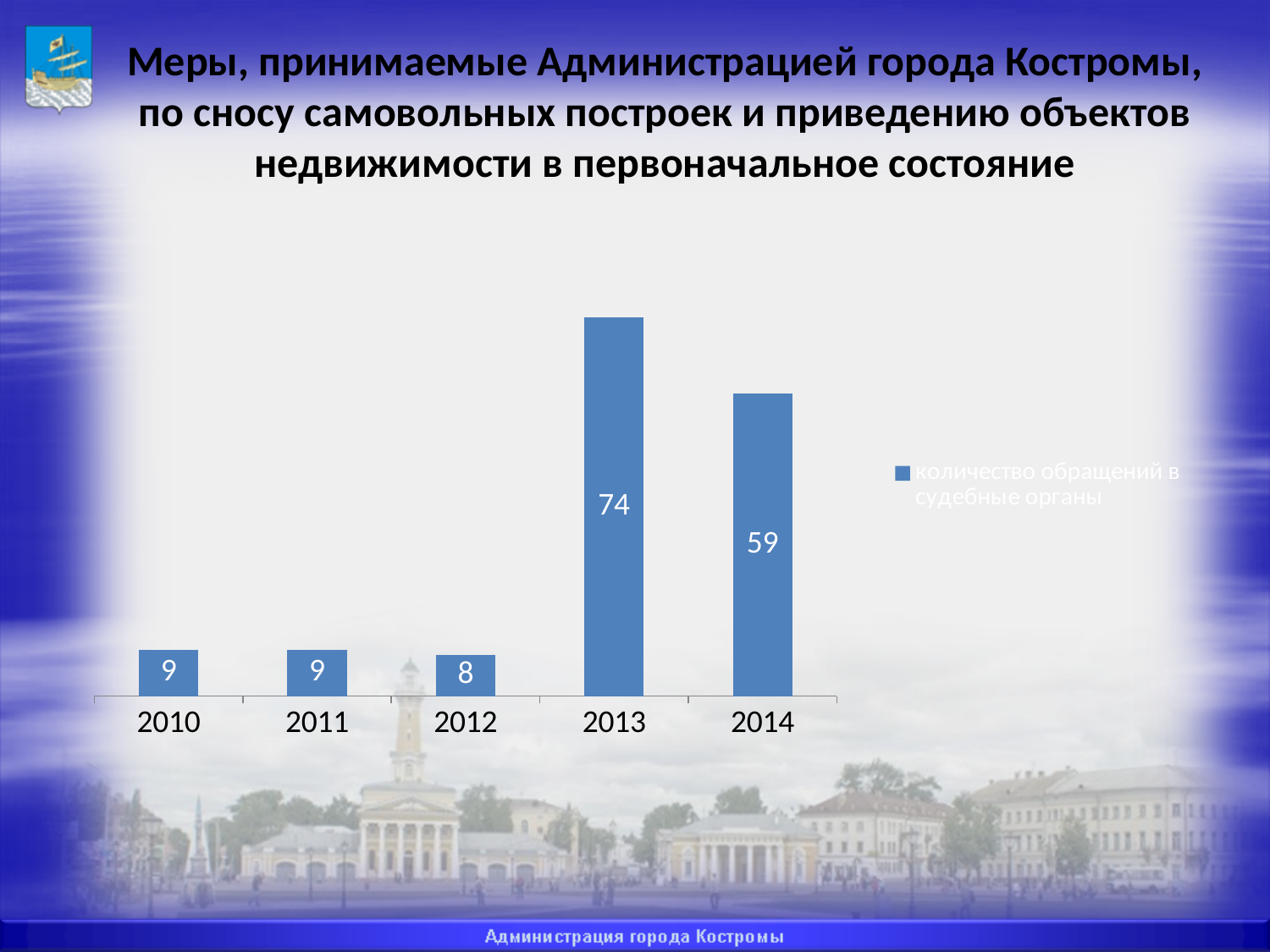
What is the value for 2013? 74 What is the value for 2010? 9 Which year has the highest value? 2013 What is the value for 2014? 59 How many series does the legend list? 1 What kind of chart is shown on the slide? Bar chart What is the difference between the values for 2013 and 2014? 15 Which is larger, the value for 2013 or the value for 2014? 2013 How many years are shown on the x axis? 5 What is the difference between the values for 2014 and 2012? 51 What is the value for 2012? 8 Which year has the lowest value? 2012